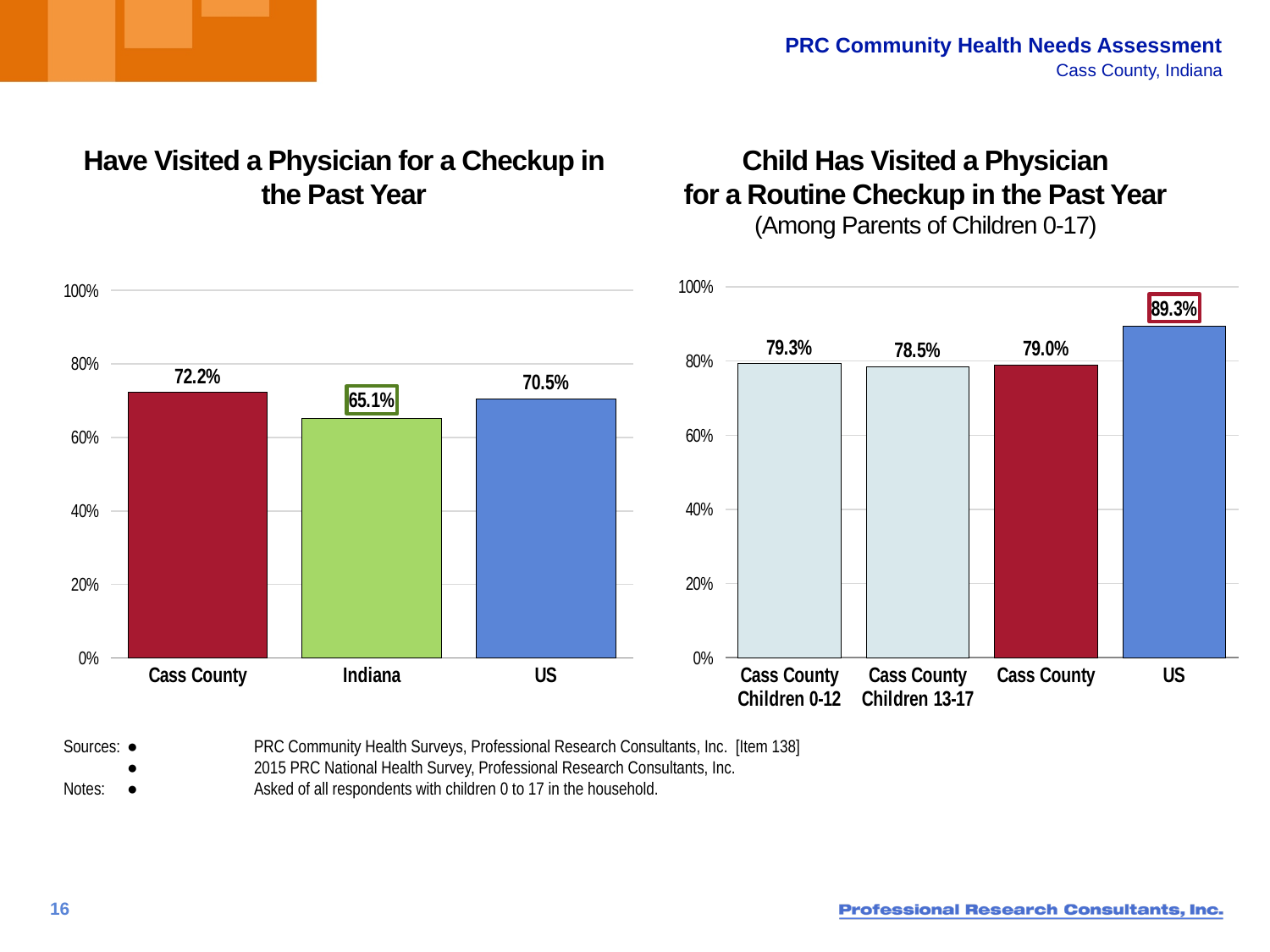
In the right chart 'Child Has Visited a Physician for a Routine Checkup in the Past Year', what is the value for Cass County Children 13-17? 78.5% In the left chart 'Have Visited a Physician for a Checkup in the Past Year', what is the value for Cass County? 72.2% In the right chart 'Child Has Visited a Physician for a Routine Checkup in the Past Year', how many categories are shown? 4 In the left chart 'Have Visited a Physician for a Checkup in the Past Year', which category has the lowest value? Indiana In the left chart 'Have Visited a Physician for a Checkup in the Past Year', how many categories are shown? 3 What type of chart is the left chart 'Have Visited a Physician for a Checkup in the Past Year'? Bar chart In the left chart 'Have Visited a Physician for a Checkup in the Past Year', what is the value for Indiana? 65.1% In the right chart 'Child Has Visited a Physician for a Routine Checkup in the Past Year', what is the difference between the US and Cass County values? 10.3% In the right chart 'Child Has Visited a Physician for a Routine Checkup in the Past Year', what is the value for US? 89.3% In the right chart 'Child Has Visited a Physician for a Routine Checkup in the Past Year', which category has the highest value? US In the left chart 'Have Visited a Physician for a Checkup in the Past Year', what is the difference between the Cass County and US values? 1.7% In the right chart 'Child Has Visited a Physician for a Routine Checkup in the Past Year', is the value for Cass County Children 0-12 greater or less than 80%? less